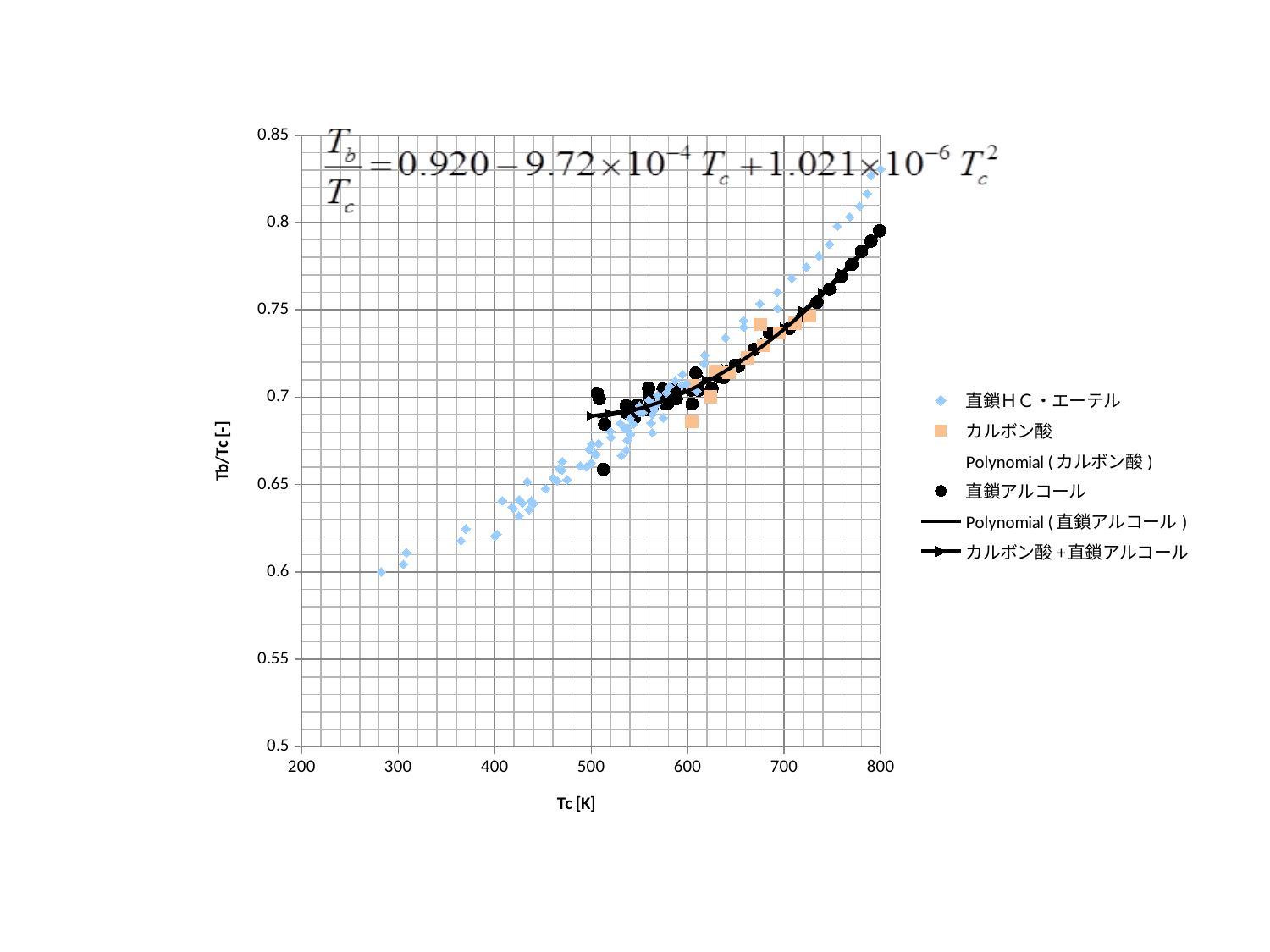
How many entries does the legend list? 6 What is the label of the x axis? Tc [K] Which series reaches the highest Tb/Tc value on the chart? 直鎖HC・エーテル What is the constant term in the equation shown at the top of the chart? 0.920 What kind of chart is shown on the slide? scatter chart Do the Tb/Tc values rise or fall as Tc increases along the x axis? rise Is the Tb/Tc value of the 直鎖アルコール point at Tc = 800 greater or less than 0.75? greater Is the highest Tb/Tc value of the 直鎖HC・エーテル series greater or less than 0.8? greater Which series reaches a higher maximum Tb/Tc value, 直鎖アルコール or カルボン酸? 直鎖アルコール Which series contains the point with the lowest Tc value? 直鎖HC・エーテル Is the Tb/Tc value of the lowest 直鎖アルコール point (near Tc = 510) greater or less than 0.7? less